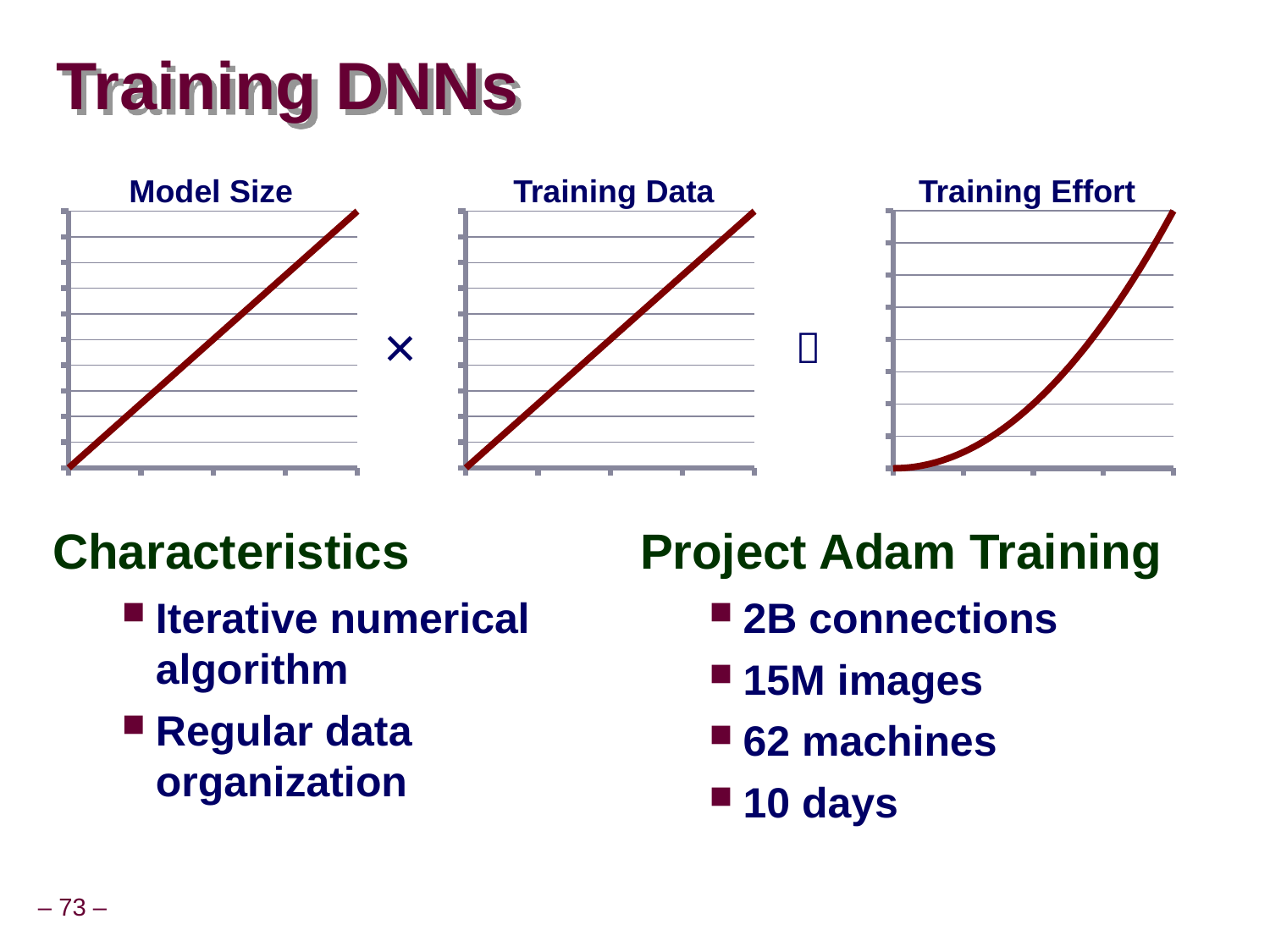
What is the title of the chart in the middle of the slide? Training Data In the "Training Effort" chart, does the line rise or fall along the x axis? rise In the "Training Data" chart, does the line rise or fall along the x axis? rise How many charts are shown on the slide? 3 What kind of chart is the "Training Effort" chart? line chart What kind of chart is the "Model Size" chart? line chart In the "Model Size" chart, does the line rise or fall along the x axis? rise What is the title of the chart on the right of the slide? Training Effort